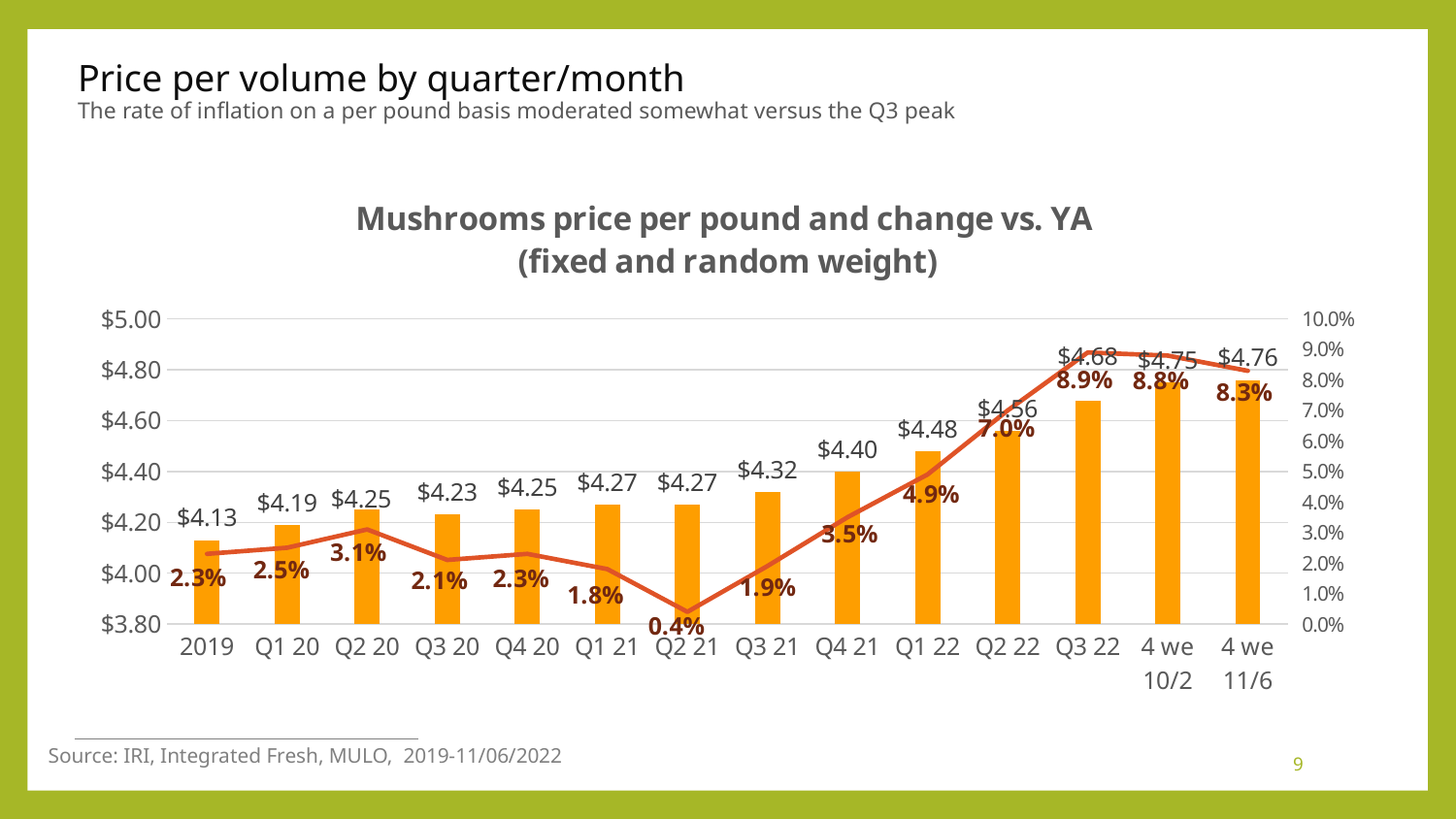
What is the change vs. YA shown for the 4 we 11/6 period? 8.3% By how many percentage points does the change vs. YA in Q3 22 exceed that in Q2 22? 1.9 percentage points What is the change vs. YA shown for Q2 21? 0.4% What is the mushroom price per pound for Q3 22? $4.68 How many periods are shown on the x axis? 14 How much higher is the price per pound in Q3 22 than in 2019? $0.55 Which period has the lowest change vs. YA? Q2 21 Do the price per pound bars generally rise or fall from 2019 to 4 we 11/6? Rise Which period has the highest change vs. YA? Q3 22 Which has the higher price per pound, Q4 21 or Q1 22? Q1 22 Which period has the highest price per pound? 4 we 11/6 What kind of chart is this? Combination bar and line chart